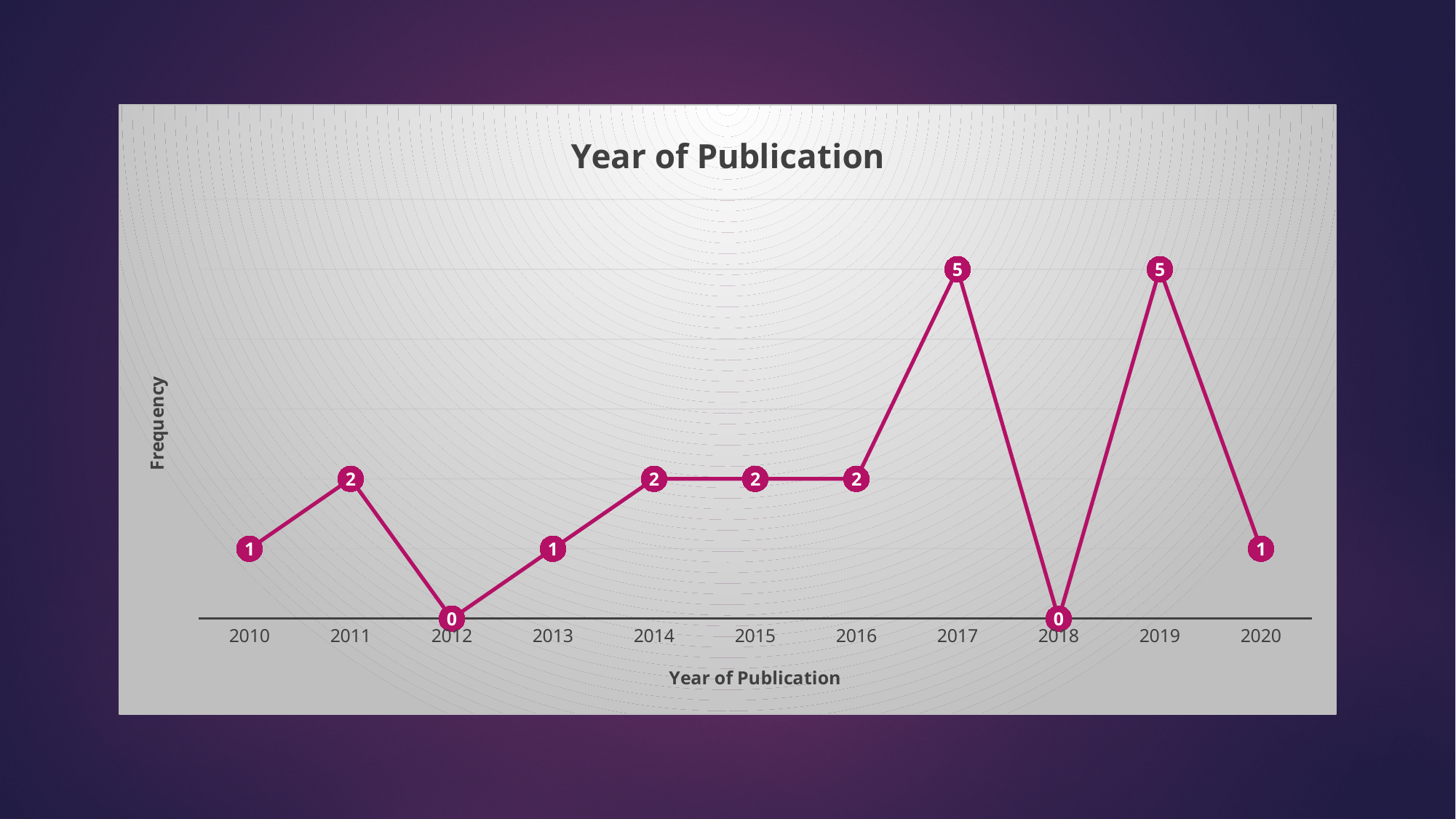
How many years are plotted on the x axis? 11 What is the frequency for 2020? 1 Which has a higher frequency, 2011 or 2010? 2011 What is the frequency for 2013? 1 What kind of chart is shown? Line chart What is the difference between the frequency for 2019 and the frequency for 2020? 4 What is the frequency for 2018? 0 Does the frequency rise or fall from 2012 to 2014? Rise What is the title of the chart? Year of Publication Which years have the highest frequency? 2017 and 2019 What is the frequency for 2017? 5 Which years have the lowest frequency? 2012 and 2018